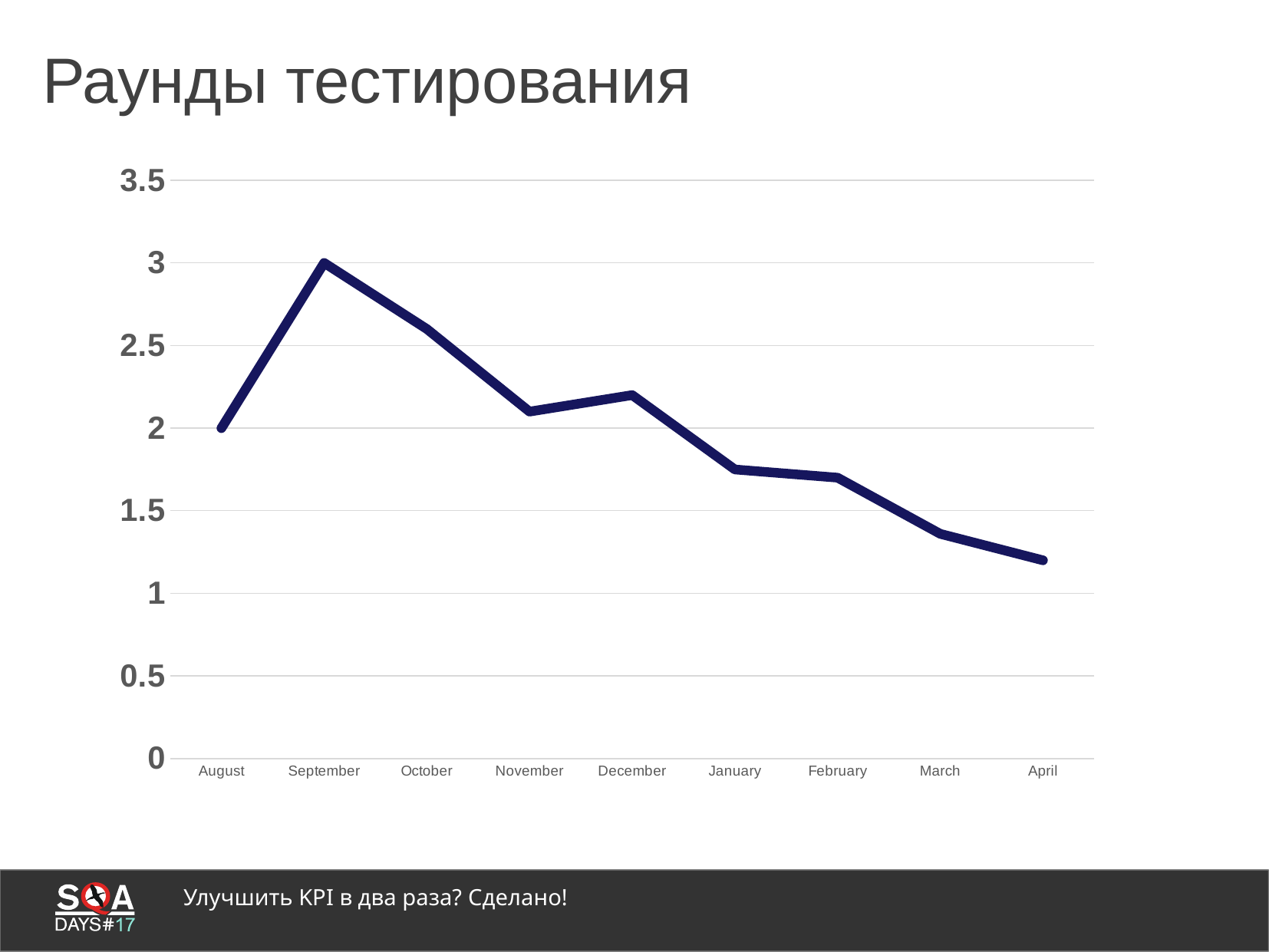
Which month has the highest value? September How many months are plotted along the x axis? 9 Which is larger, the value for October or the value for November? October What kind of chart is shown on the slide? line chart What is the value for August? 2 Which month has the lowest value? April Is the value for October greater or less than 2.5? greater What is the title of the chart? Раунды тестирования Is the value for January greater or less than 2? less What is the value for September? 3 Is the value for March greater or less than 1.5? less What is the difference between the values for September and August? 1